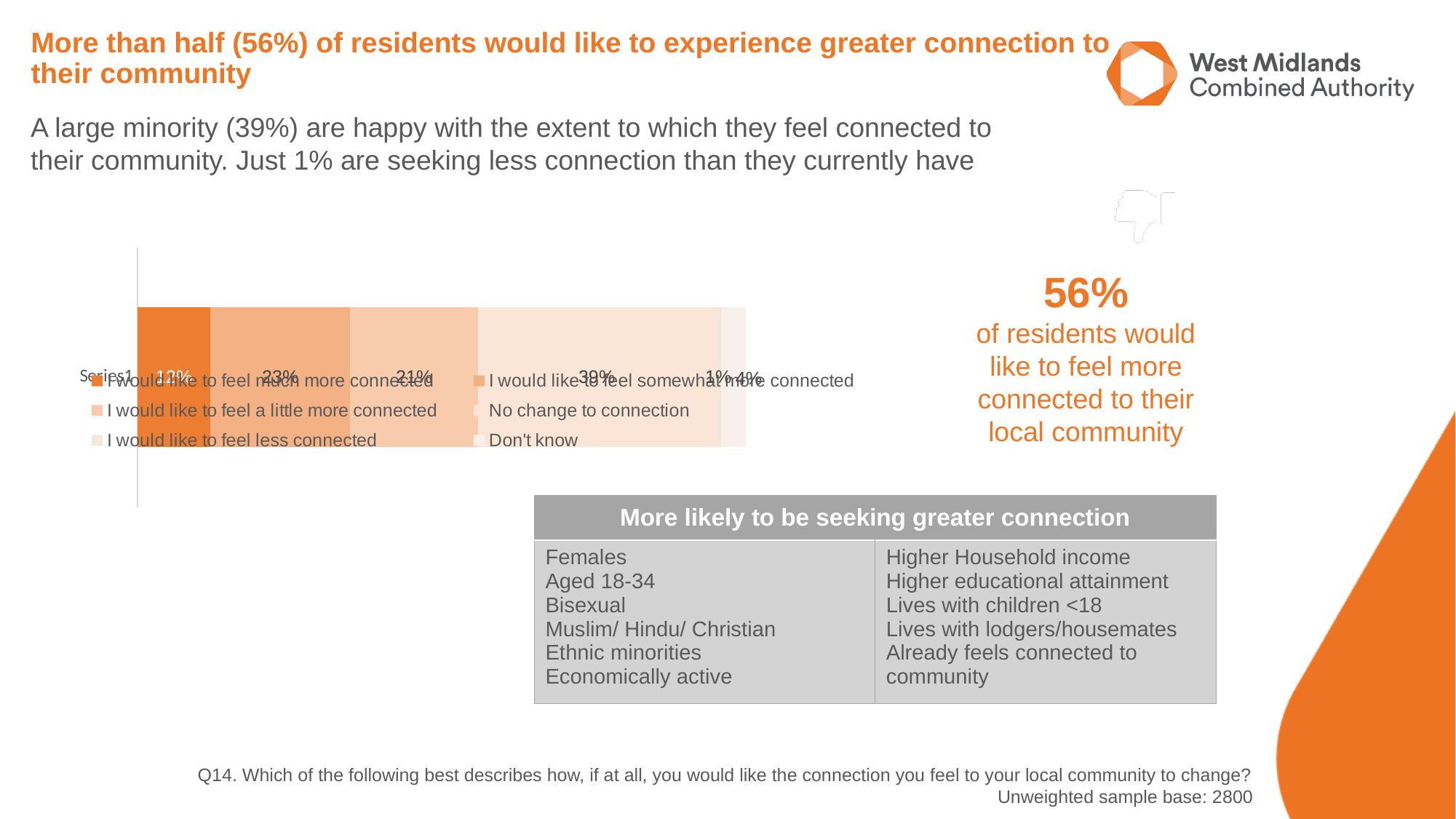
What percentage of residents answered 'Don't know'? 4% Which response has the largest share in the bar? No change to connection What percentage of residents would like to feel somewhat more connected? 23% What is the difference between the 'No change to connection' share and the 'I would like to feel much more connected' share? 27% How many entries does the chart legend list? 6 What percentage of residents would like to feel much more connected? 12% Which response has the smallest share in the bar? I would like to feel less connected What percentage of residents would like to feel less connected? 1% Which is larger: the share wanting to feel somewhat more connected or the share wanting to feel a little more connected? I would like to feel somewhat more connected What percentage of residents said 'No change to connection'? 39% What kind of chart is shown on the slide? Stacked bar chart What percentage of residents would like to feel a little more connected? 21%